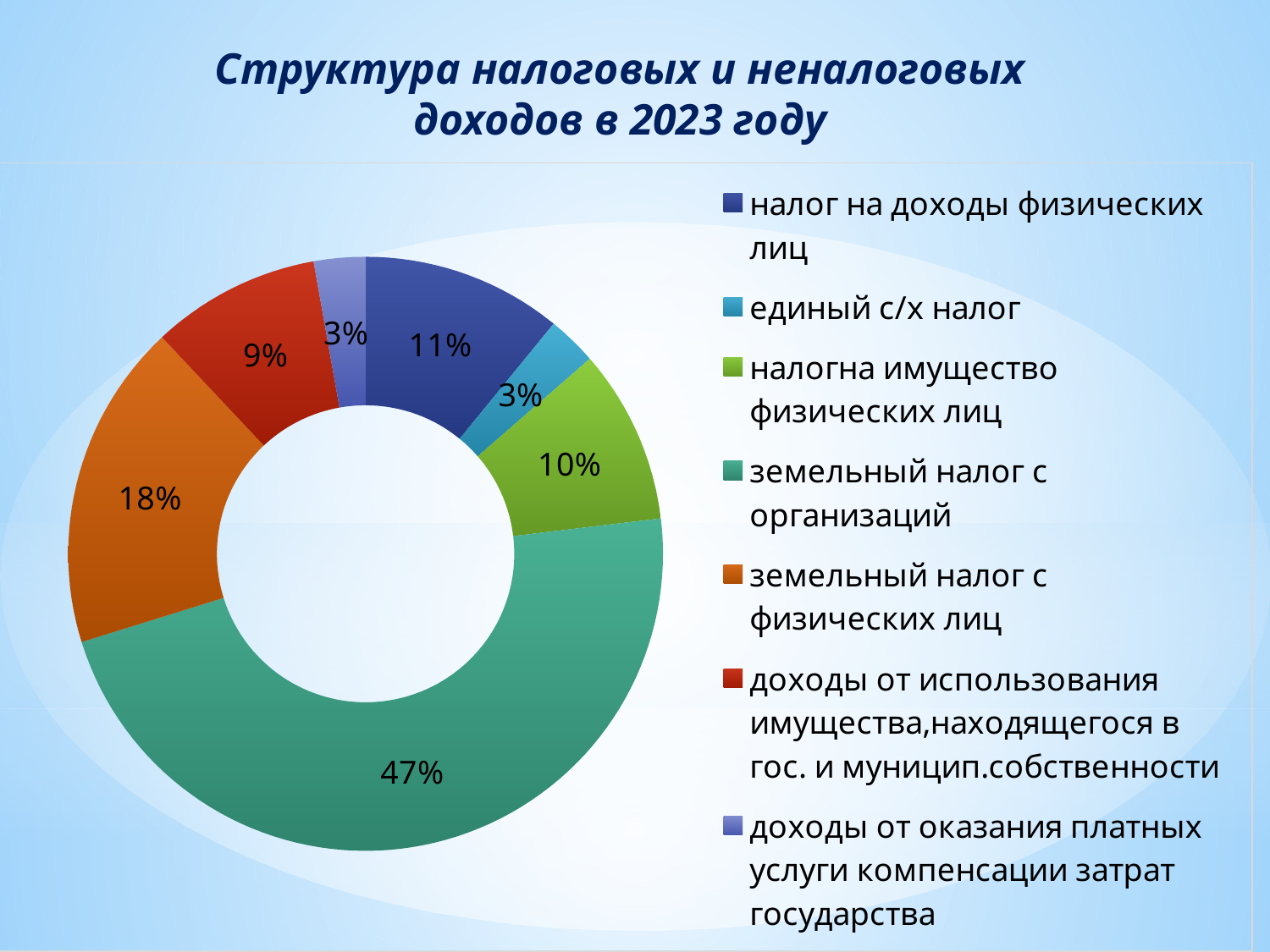
What is the difference between the shares of земельный налог с организаций and земельный налог с физических лиц? 29% What share of the chart does земельный налог с организаций account for? 47% What is the value shown for единый с/х налог? 3% What is the value shown for налог на доходы физических лиц? 11% What is the value shown for налог на имущество физических лиц? 10% What is the value shown for доходы от использования имущества, находящегося в гос. и муницип. собственности? 9% What is the value shown for земельный налог с физических лиц? 18% How many categories does the chart show? 7 Which is larger: the share of налог на доходы физических лиц or the share of налог на имущество физических лиц? налог на доходы физических лиц Which category has the largest share of the chart? земельный налог с организаций What kind of chart is shown on the slide? doughnut (pie) chart What is the title of the slide's chart? Структура налоговых и неналоговых доходов в 2023 году